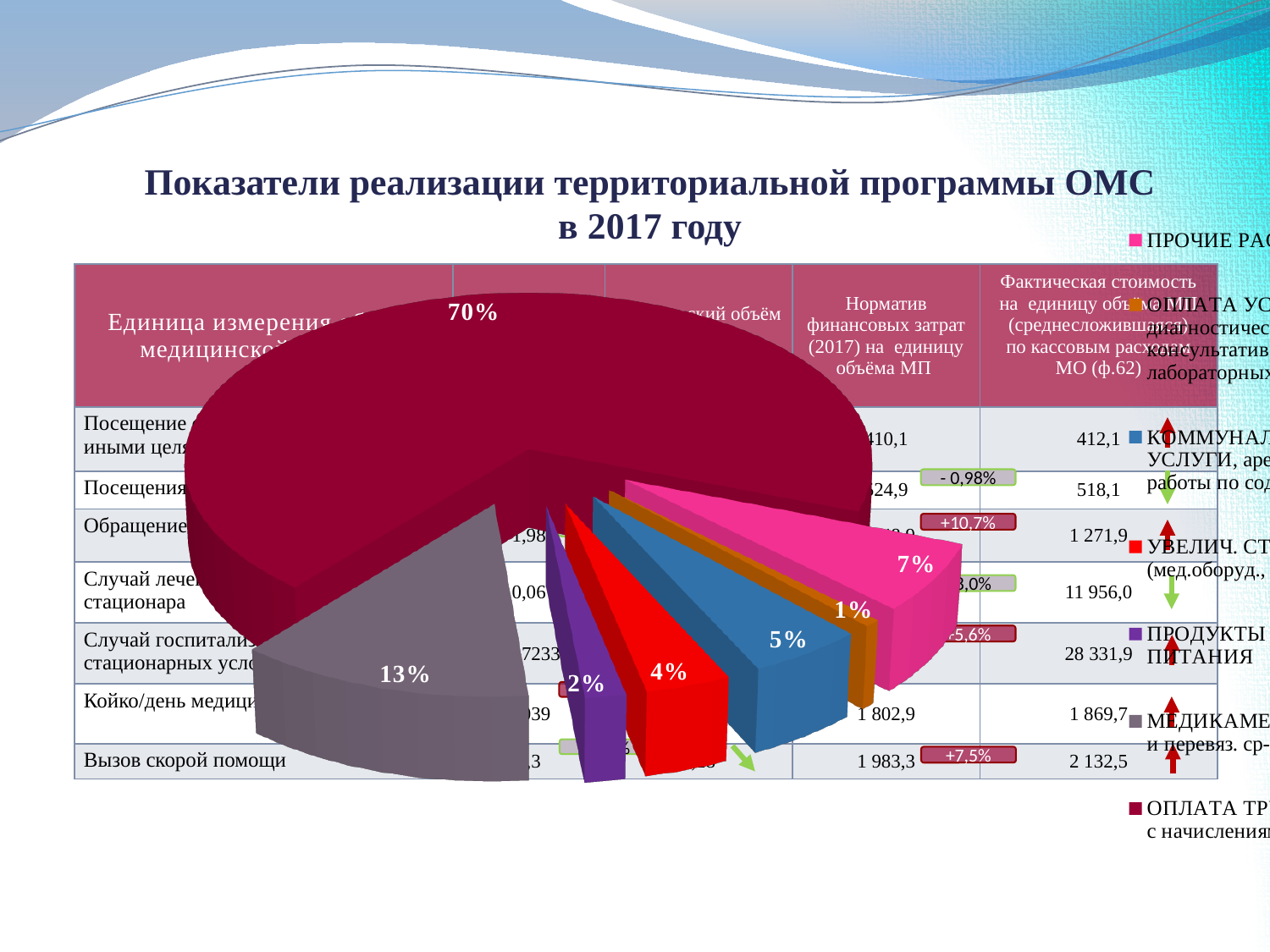
What is the percentage shown on the smallest slice of the pie chart? 1% Is the share of the ПРОДУКТЫ ПИТАНИЯ slice greater or less than 5%? less Which is larger: the 13% slice or the 7% slice? the 13% slice What colour is the largest (70%) slice of the pie chart? dark red What kind of chart is shown on the slide? pie chart What share of the pie does the ПРОДУКТЫ ПИТАНИЯ slice represent? 2% What colour is the ПРОДУКТЫ ПИТАНИЯ slice in the pie chart? purple What is the difference in percentage points between the largest slice (70%) and the second-largest slice (13%)? 57 percentage points How many slices does the pie chart have? 7 How many entries does the legend of the pie chart list? 7 What is the percentage shown on the second-largest slice of the pie chart? 13% What is the percentage shown on the largest slice of the pie chart? 70%